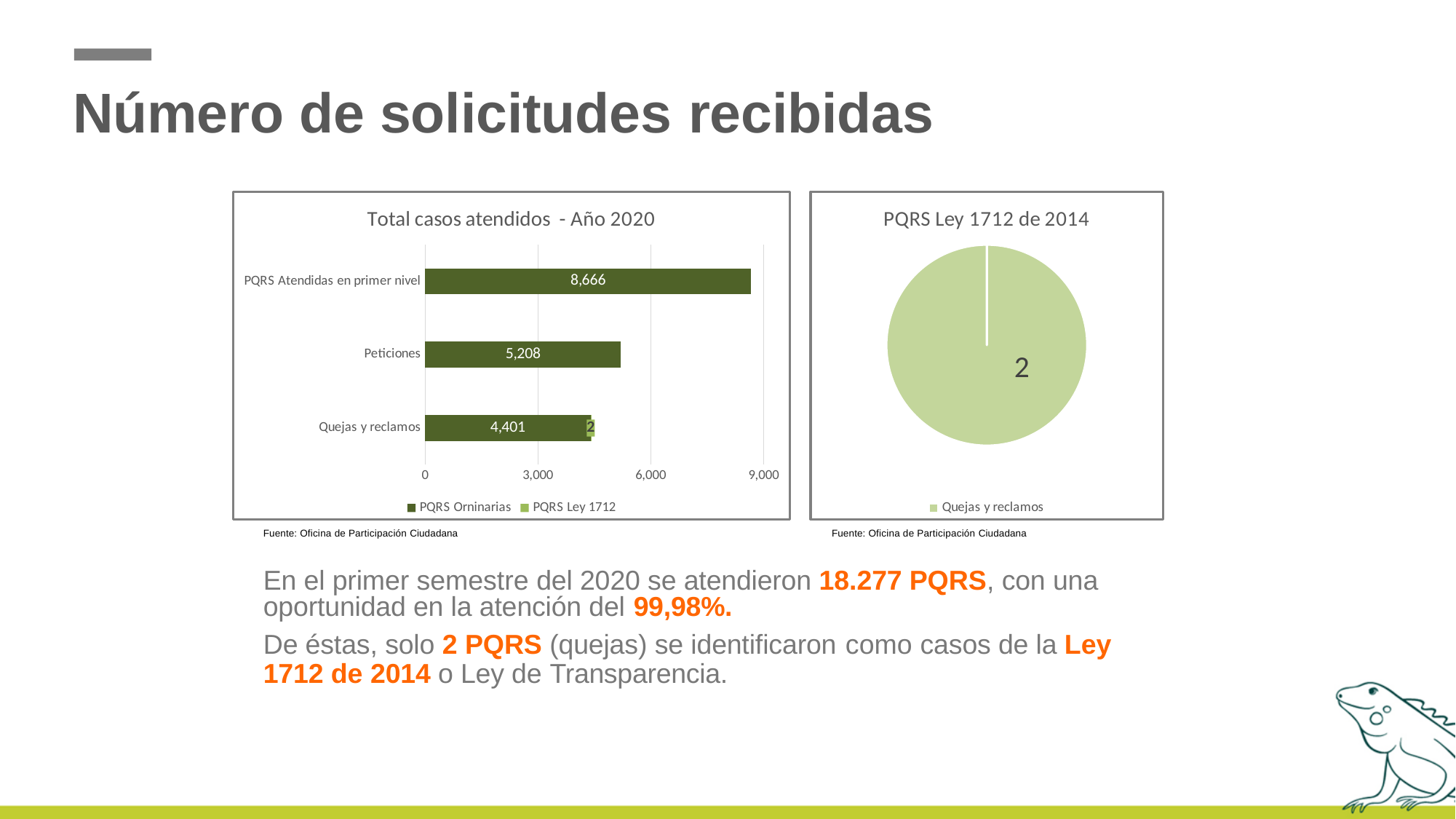
What kind of chart is the one titled "PQRS Ley 1712 de 2014"? Pie chart In the chart titled "Total casos atendidos - Año 2020", what is the difference between the values for PQRS Atendidas en primer nivel and Peticiones? 3,458 What kind of chart is the one titled "Total casos atendidos - Año 2020"? Bar chart In the chart titled "Total casos atendidos - Año 2020", what is the value for PQRS Atendidas en primer nivel? 8,666 In the chart titled "Total casos atendidos - Año 2020", what is the PQRS Orninarias value for Quejas y reclamos? 4,401 In the chart titled "Total casos atendidos - Año 2020", what is the value for Peticiones? 5,208 In the chart titled "Total casos atendidos - Año 2020", how many series does the legend list? 2 In the chart titled "Total casos atendidos - Año 2020", how many categories are shown on the vertical axis? 3 In the chart titled "Total casos atendidos - Año 2020", which is larger: Peticiones or Quejas y reclamos (PQRS Orninarias)? Peticiones In the chart titled "Total casos atendidos - Año 2020", which category has the highest value? PQRS Atendidas en primer nivel In the chart titled "Total casos atendidos - Año 2020", which category has the lowest PQRS Orninarias value? Quejas y reclamos In the chart titled "PQRS Ley 1712 de 2014", what value is shown for Quejas y reclamos? 2